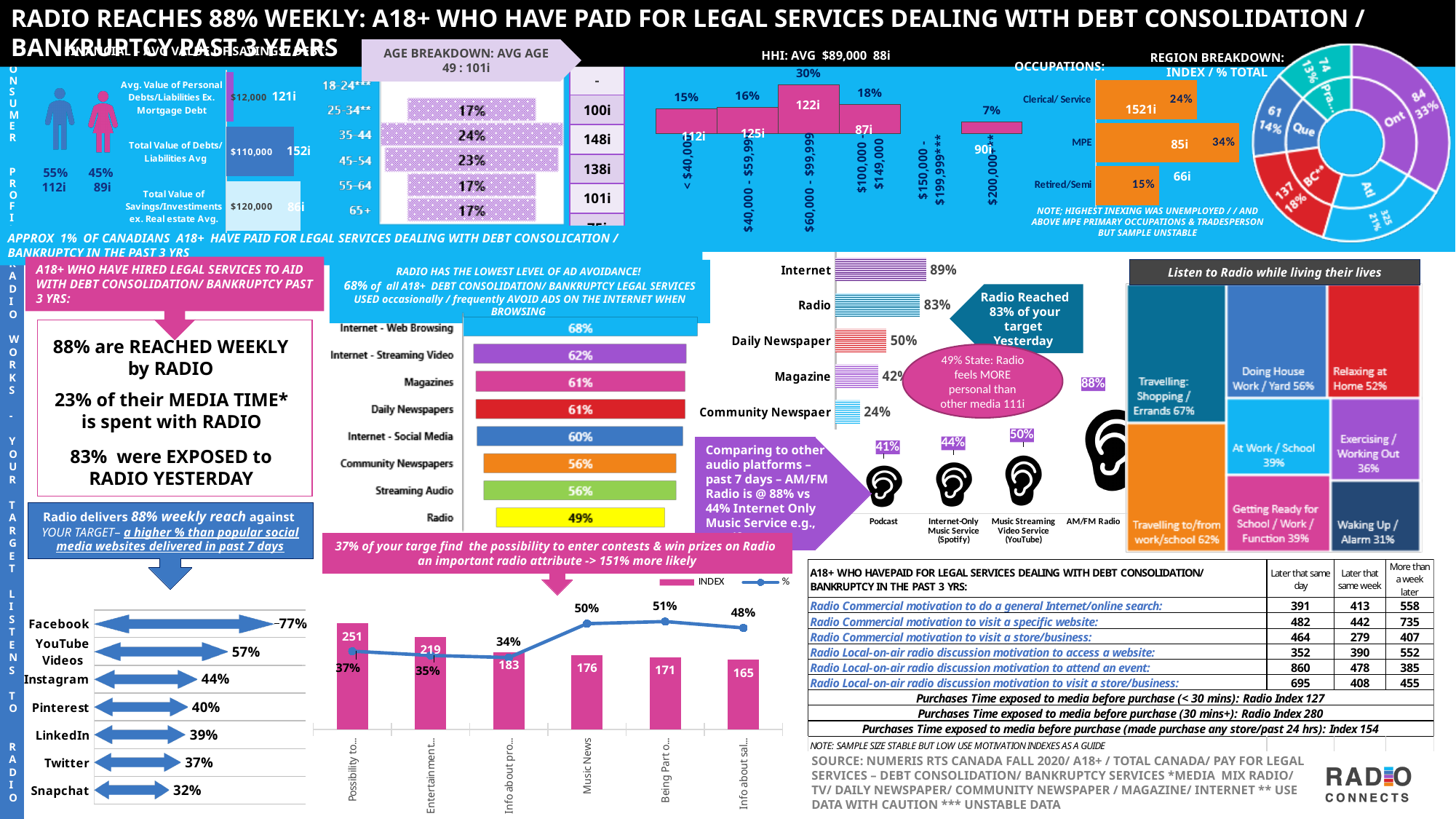
In the radio attributes chart at the bottom centre, what is the INDEX value for Music News? 176 In the social media weekly reach chart, which is larger, YouTube Videos or Instagram? YouTube Videos In the ad avoidance bar chart, which category has the lowest value? Radio In the social media weekly reach chart, what is the value for Pinterest? 40% In the social media weekly reach chart (Facebook, YouTube Videos, Instagram, etc.), how many categories are shown? 7 In the "Listen to Radio while living their lives" chart, what is the value for Relaxing at Home? 52% In the ad avoidance bar chart ("Radio has the lowest level of ad avoidance"), what is the value for Internet - Web Browsing? 68% In the audio platforms chart (Podcast, Internet-Only Music Service, Music Streaming Video Service, AM/FM Radio), what is the value for Podcast? 41% In the media reached yesterday chart, which category has the highest value? Internet In the radio attributes chart at the bottom centre, how many series does the legend list? 2 In the ad avoidance bar chart, what is the difference between Internet - Streaming Video and Radio? 13% In the media reached yesterday chart (Internet, Radio, Daily Newspaper, Magazine, Community Newspaper), what is the value for Daily Newspaper? 50%